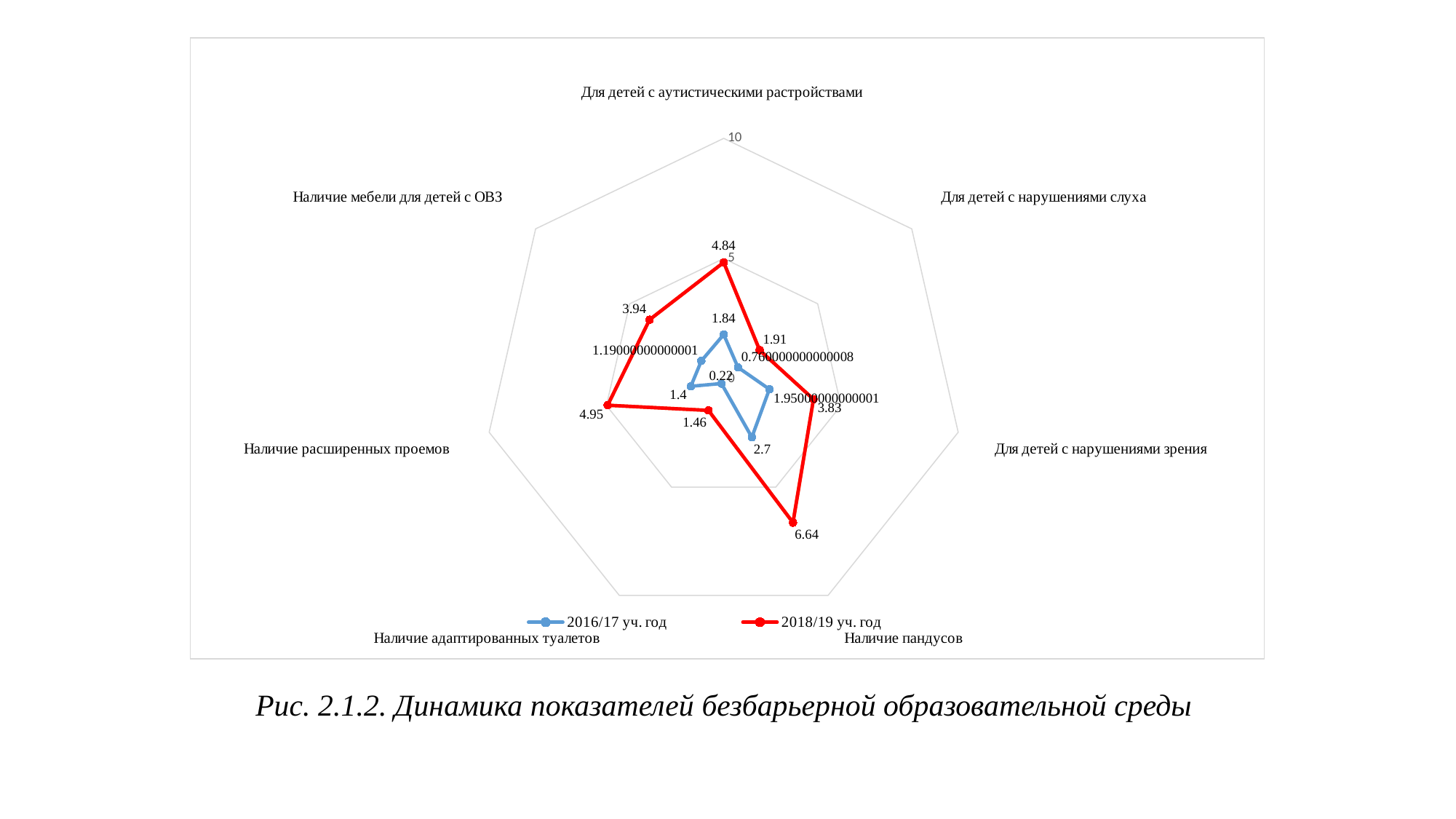
Which category has the highest value in the 2018/19 уч. год series? Наличие пандусов How many series does the legend list? 2 What is the value for 'Наличие пандусов' in the 2018/19 уч. год series? 6.64 What is the value for 'Наличие расширенных проемов' in the 2018/19 уч. год series? 4.95 How many categories (axes) does the radar chart have? 7 What is the maximum value shown on the radar chart's axis scale? 10 What is the value for 'Для детей с аутистическими растройствами' in the 2016/17 уч. год series? 1.84 Which series has the larger value for 'Наличие мебели для детей с ОВЗ', 2016/17 уч. год or 2018/19 уч. год? 2018/19 уч. год Which category has the lowest value in the 2016/17 уч. год series? Наличие адаптированных туалетов Is the 2018/19 уч. год value for 'Наличие пандусов' greater or less than 5? greater What is the difference between the 2018/19 and 2016/17 values for 'Наличие пандусов'? 3.94 What kind of chart is shown on the slide? Radar chart